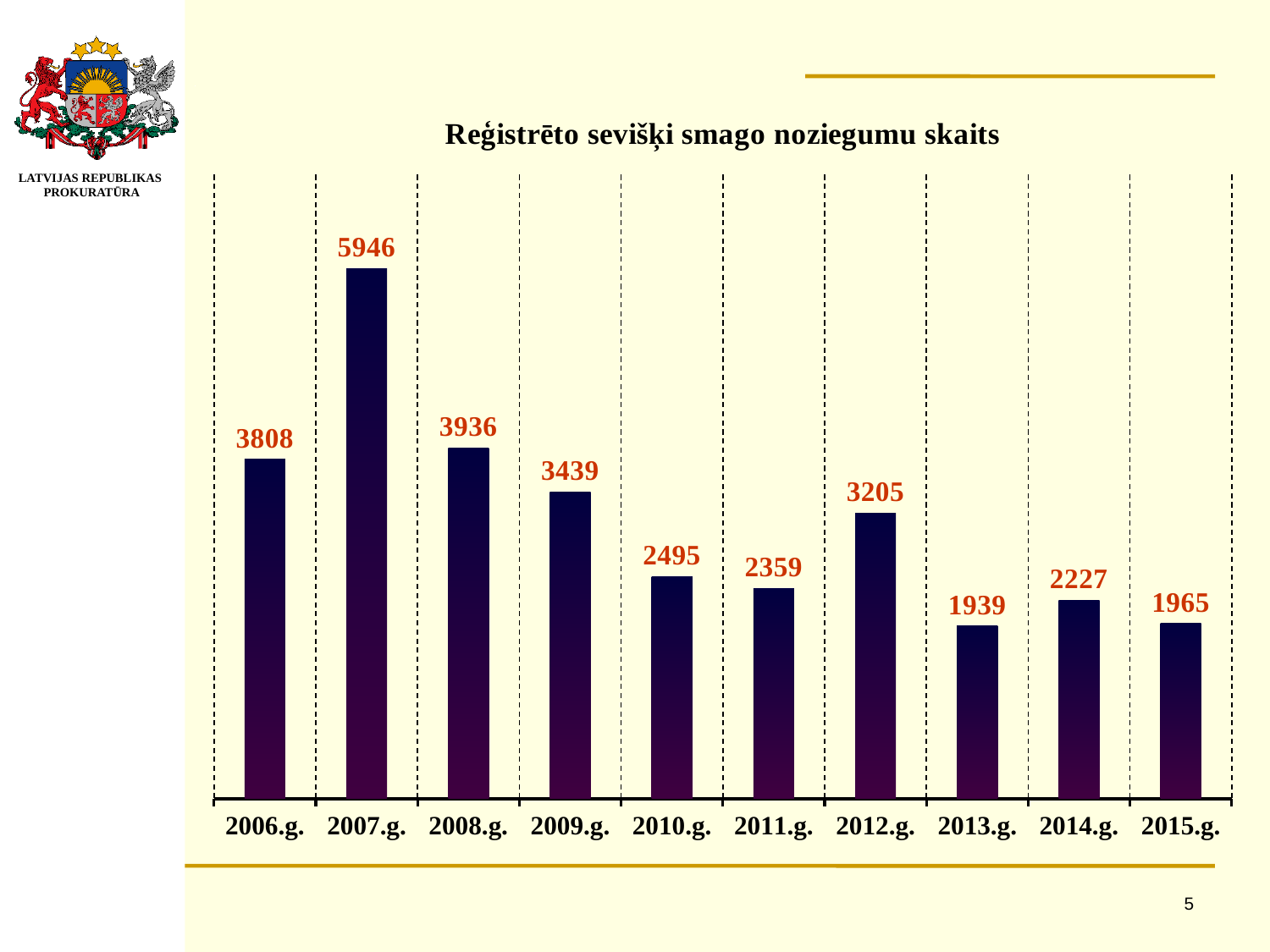
Which year has the highest value? 2007.g. What is the title of the chart? Reģistrēto sevišķi smago noziegumu skaits What is the value for 2013.g.? 1939 Which year has the lowest value? 2013.g. What kind of chart is this? bar chart What is the value for 2010.g.? 2495 Which is larger, the value for 2011.g. or the value for 2012.g.? 2012.g. Which is larger, the value for 2006.g. or the value for 2008.g.? 2008.g. What is the difference between the values for 2007.g. and 2008.g.? 2010 What is the difference between the values for 2014.g. and 2015.g.? 262 How many years are shown on the x axis? 10 What is the value for 2007.g.? 5946